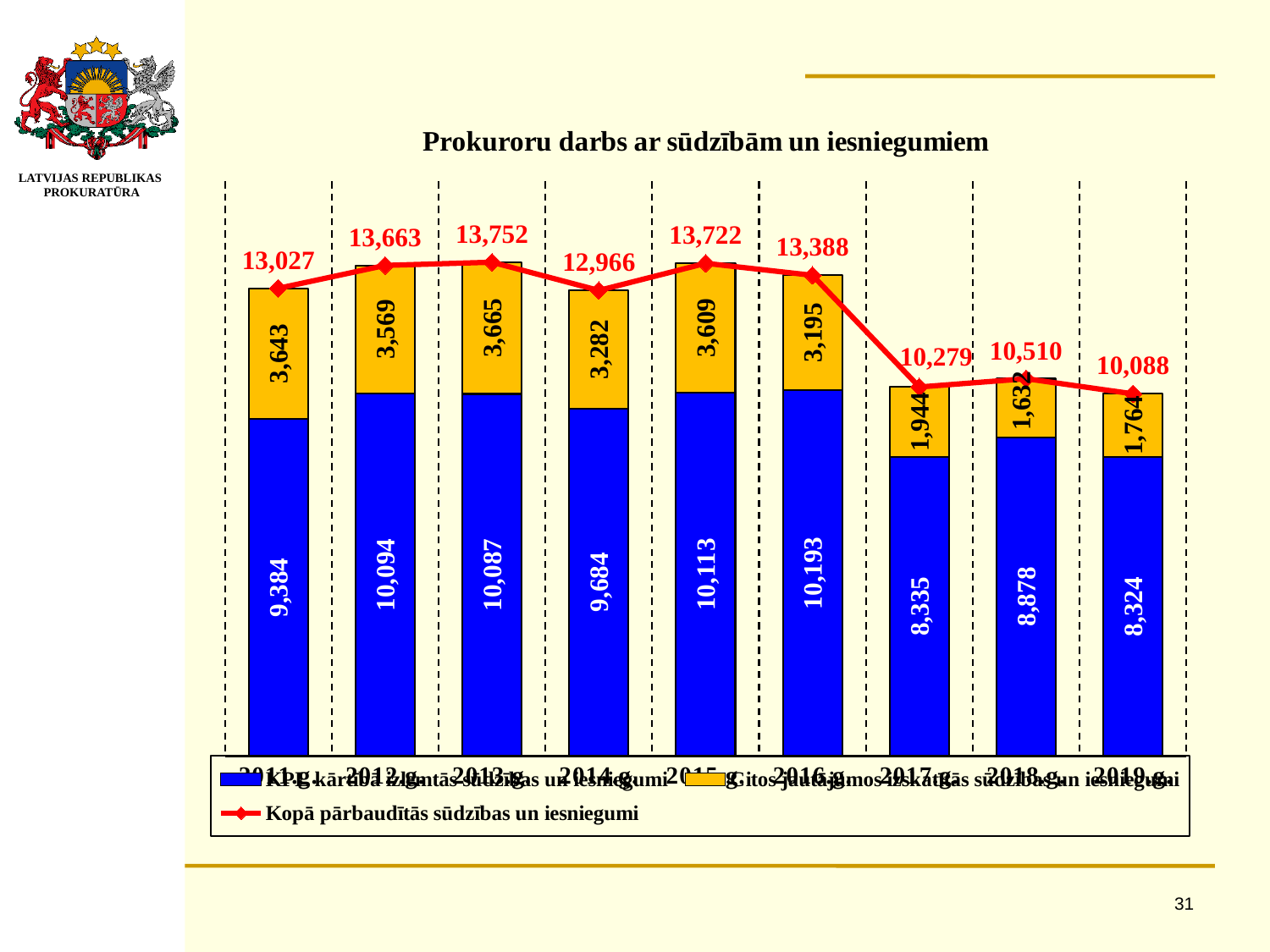
What is the value of the yellow bar segment for 2017? 1,944 Which year has the larger blue bar segment, 2012 or 2013? 2012 What is the total of the stacked bar for 2011 (blue plus yellow segments)? 13,027 In which year is the 'Kopā pārbaudītās sūdzības un iesniegumi' line highest? 2013 How many series does the legend list? 3 What is the value of the 'Kopā pārbaudītās sūdzības un iesniegumi' line for 2013? 13,752 Do the 'Kopā pārbaudītās sūdzības un iesniegumi' values rise or fall from 2016 to 2019? Fall By how much did the 'Kopā pārbaudītās sūdzības un iesniegumi' value fall from 2016 to 2017? 3,109 In which year is the 'Kopā pārbaudītās sūdzības un iesniegumi' line lowest? 2019 What kind of chart is shown on the slide? Stacked bar chart with a line What is the value of the blue bar segment for 2016? 10,193 How many years are shown on the x axis? 9